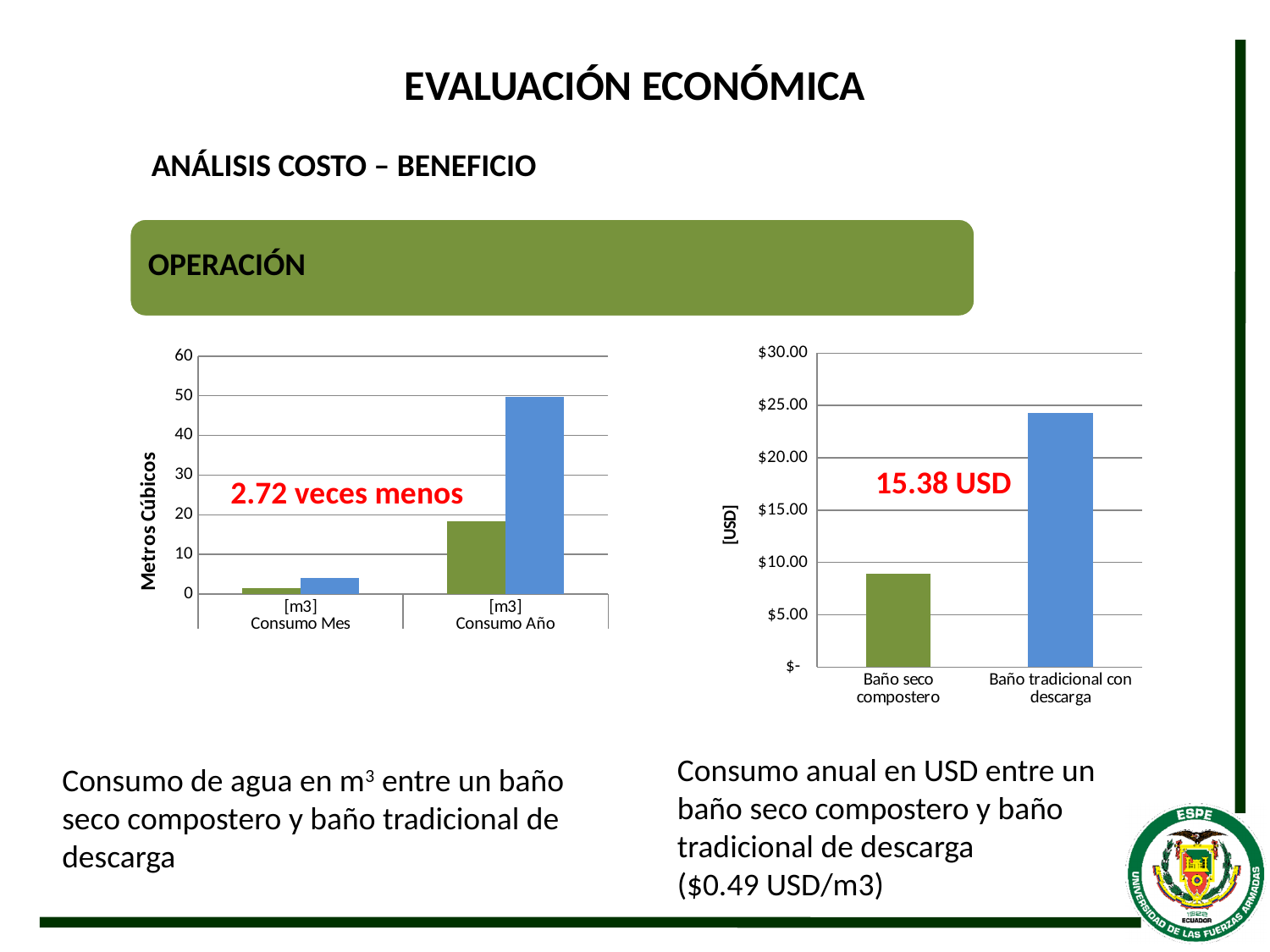
In the right chart ([USD]), which category has the highest bar? Baño tradicional con descarga In the right chart ([USD]), is the value for Baño tradicional con descarga greater or less than $20.00? greater In the left chart (Metros Cúbicos), which is larger for Consumo Año: the green bar or the blue bar? the blue bar In the right chart ([USD]), how many categories are shown on the x axis? 2 In the left chart (Metros Cúbicos), how many categories are shown on the x axis? 2 What text is written in red inside the right chart ([USD])? 15.38 USD In the right chart ([USD]), is the value for Baño seco compostero greater or less than $10.00? less In the left chart (Metros Cúbicos), is the blue bar for Consumo Año greater or less than 40? greater What kind of chart is the left chart with the y-axis labelled 'Metros Cúbicos'? bar chart In the right chart ([USD]), which category has the lowest bar? Baño seco compostero What kind of chart is the right chart with the y-axis labelled '[USD]'? bar chart